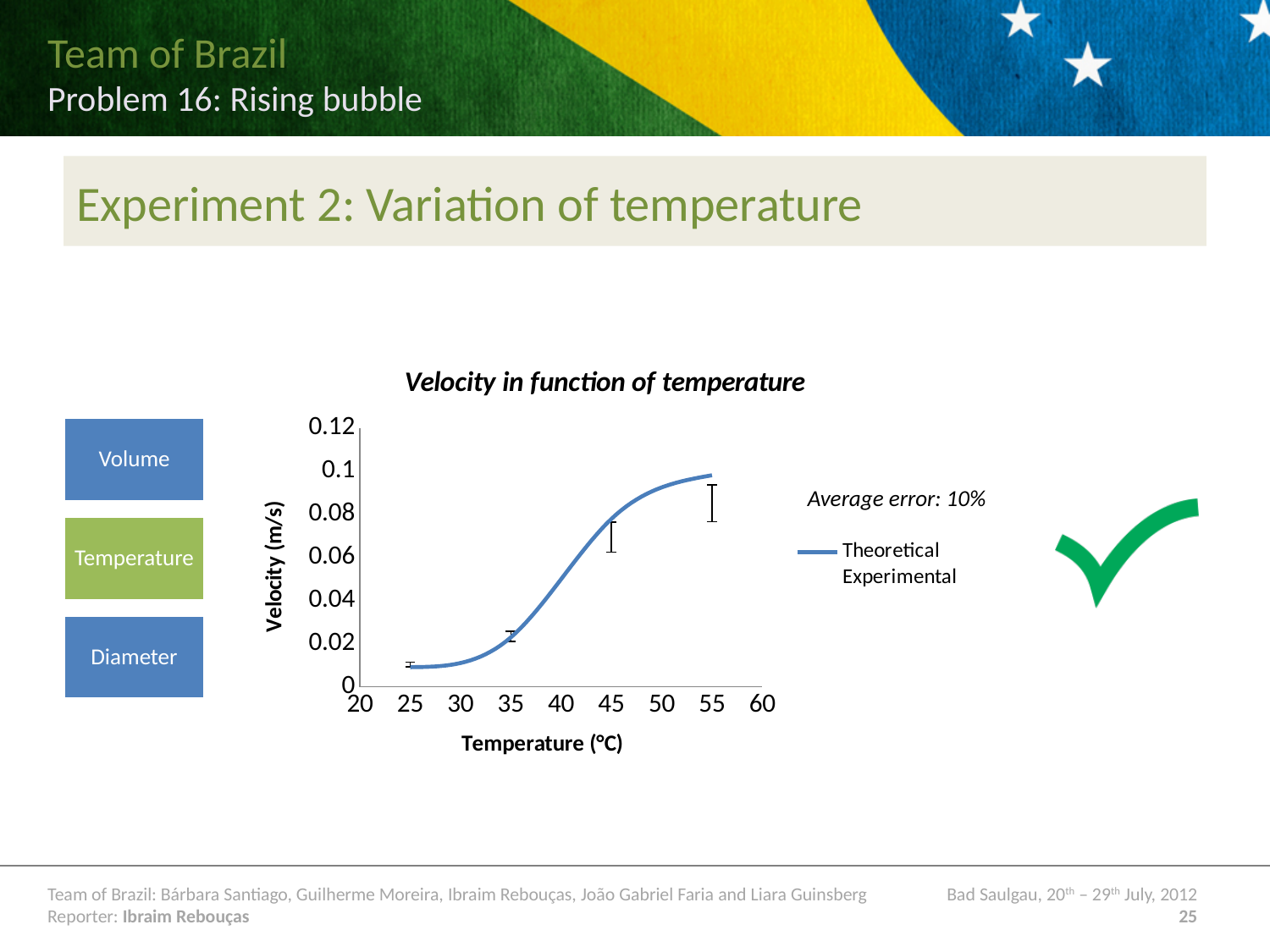
How many series does the chart legend list? 2 Is the theoretical velocity at 45 °C greater or less than 0.06 m/s? greater What is the label of the y axis of the chart? Velocity (m/s) Which temperature has the higher theoretical velocity, 35 °C or 55 °C? 55 °C Does the theoretical velocity rise or fall as temperature increases along the x axis? rise What is the title of the chart? Velocity in function of temperature Is the theoretical velocity at 25 °C greater or less than 0.02 m/s? less How many experimental data points (error bars) are plotted on the chart? 4 Is the theoretical velocity at 55 °C greater or less than 0.08 m/s? greater What kind of chart is shown on the slide? line chart What is the label of the x axis of the chart? Temperature (°C) What are the names of the two series in the chart legend? Theoretical and Experimental